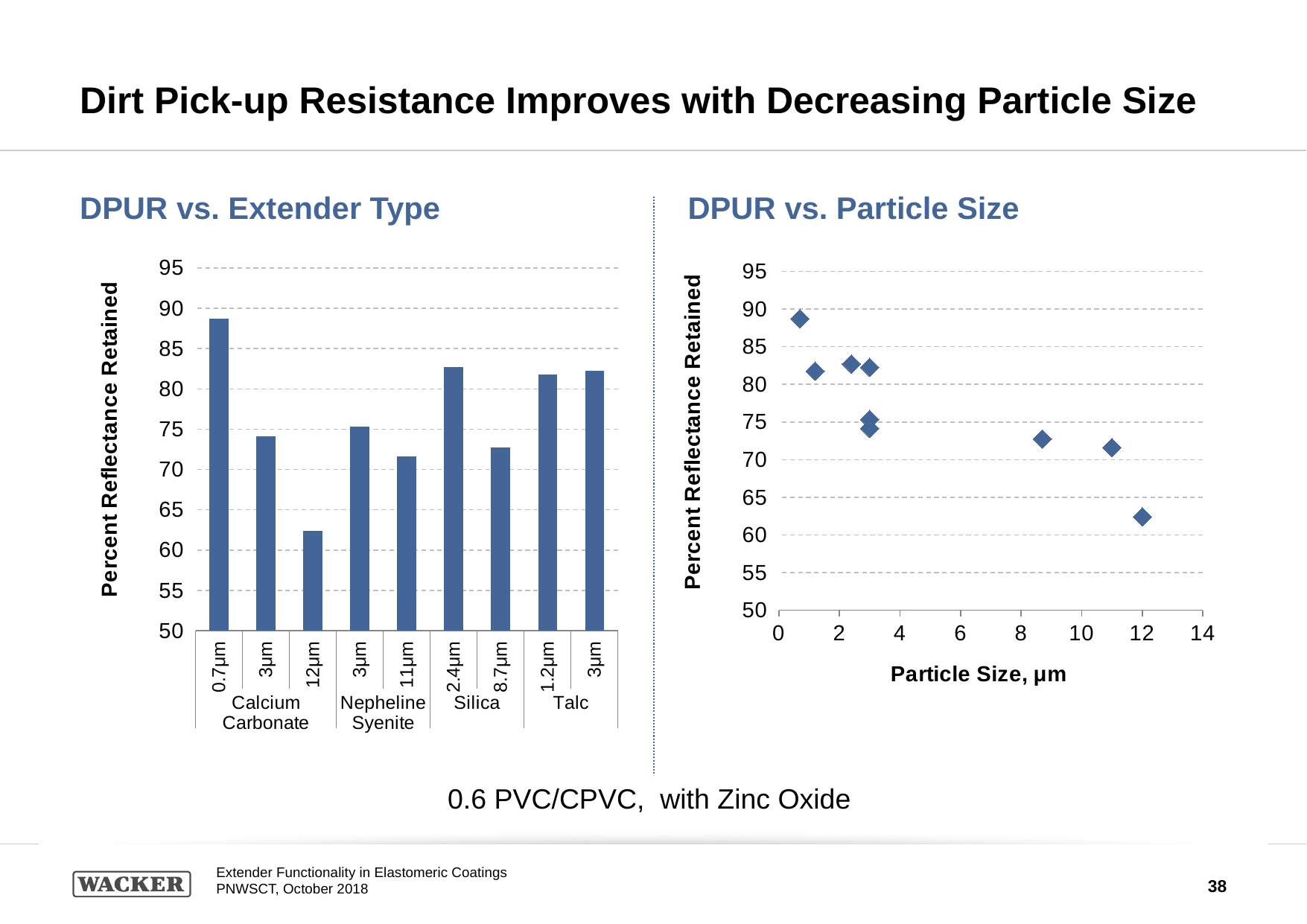
What kind of chart is the 'DPUR vs. Particle Size' chart on the right? scatter chart What is the x-axis title of the 'DPUR vs. Particle Size' chart? Particle Size, µm In the 'DPUR vs. Extender Type' chart, which Nepheline Syenite bar is higher, 3µm or 11µm? 3µm In the 'DPUR vs. Extender Type' chart, is the value for Calcium Carbonate 12µm greater or less than 65? less What kind of chart is the 'DPUR vs. Extender Type' chart on the left? bar chart In the 'DPUR vs. Particle Size' chart, do the values generally rise or fall as particle size increases? fall In the 'DPUR vs. Extender Type' chart, which Silica bar is higher, 2.4µm or 8.7µm? 2.4µm In the 'DPUR vs. Extender Type' chart, which bar has the lowest percent reflectance retained? Calcium Carbonate 12µm In the 'DPUR vs. Extender Type' chart, how many bars are plotted? 9 In the 'DPUR vs. Extender Type' chart, is the value for Calcium Carbonate 0.7µm greater or less than 85? greater In the 'DPUR vs. Extender Type' chart, which bar has the highest percent reflectance retained? Calcium Carbonate 0.7µm In the 'DPUR vs. Particle Size' chart, how many data points are plotted? 9